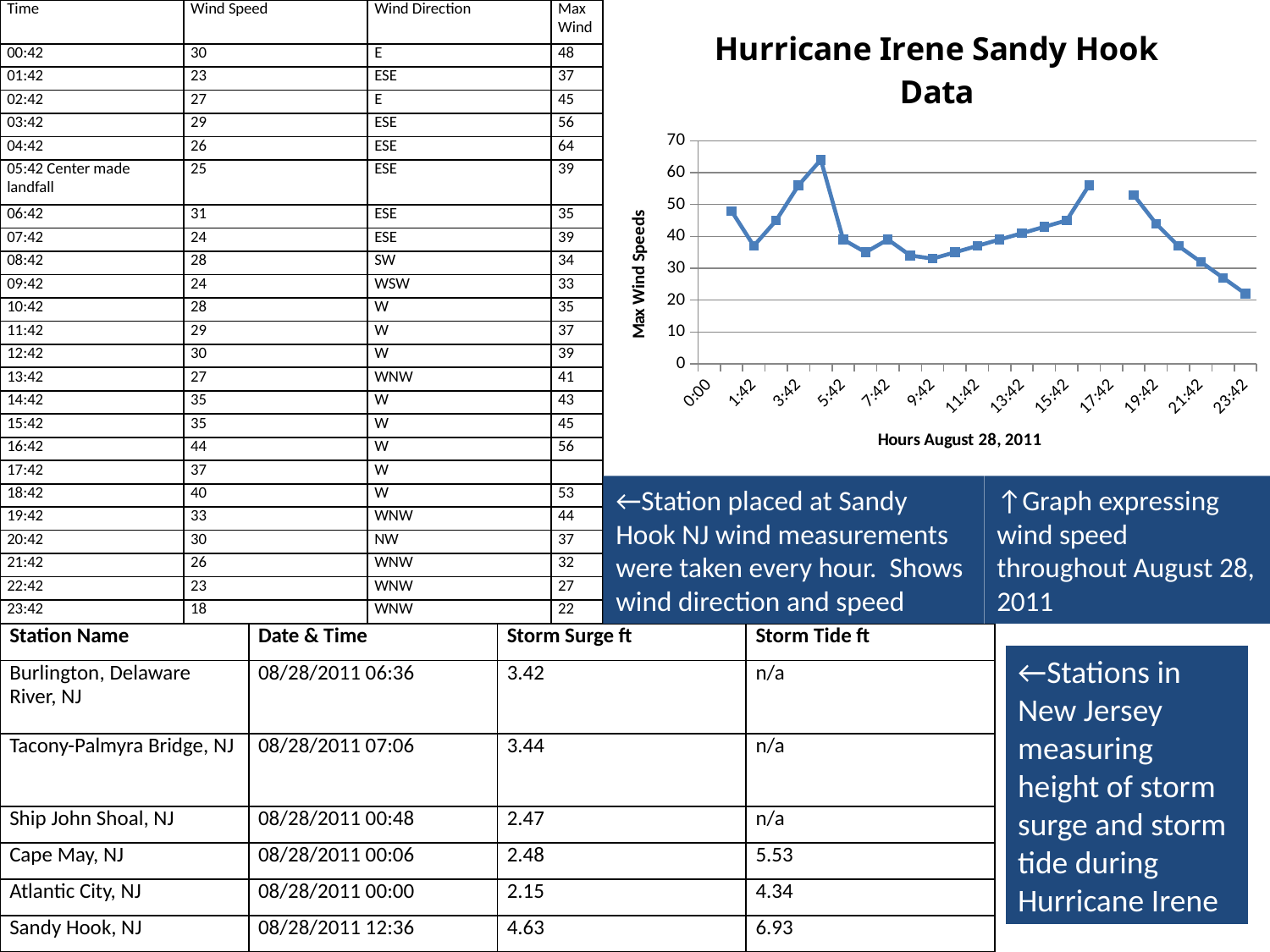
Do the values rise or fall from 19:42 to 23:42? fall At which time does the chart show its lowest max wind speed? 23:42 At which time does the chart reach its highest max wind speed? 4:42 Is the value at 23:42 greater or less than 30? less Is the value at 9:42 greater or less than 40? less What is the title of the chart? Hurricane Irene Sandy Hook Data What is the label of the vertical axis of the chart? Max Wind Speeds Is the value at 4:42 greater or less than 60? greater Do the values rise or fall from 9:42 to 15:42? rise Which is larger, the value at 4:42 or the value at 23:42? 4:42 What kind of chart is shown on the slide? line chart